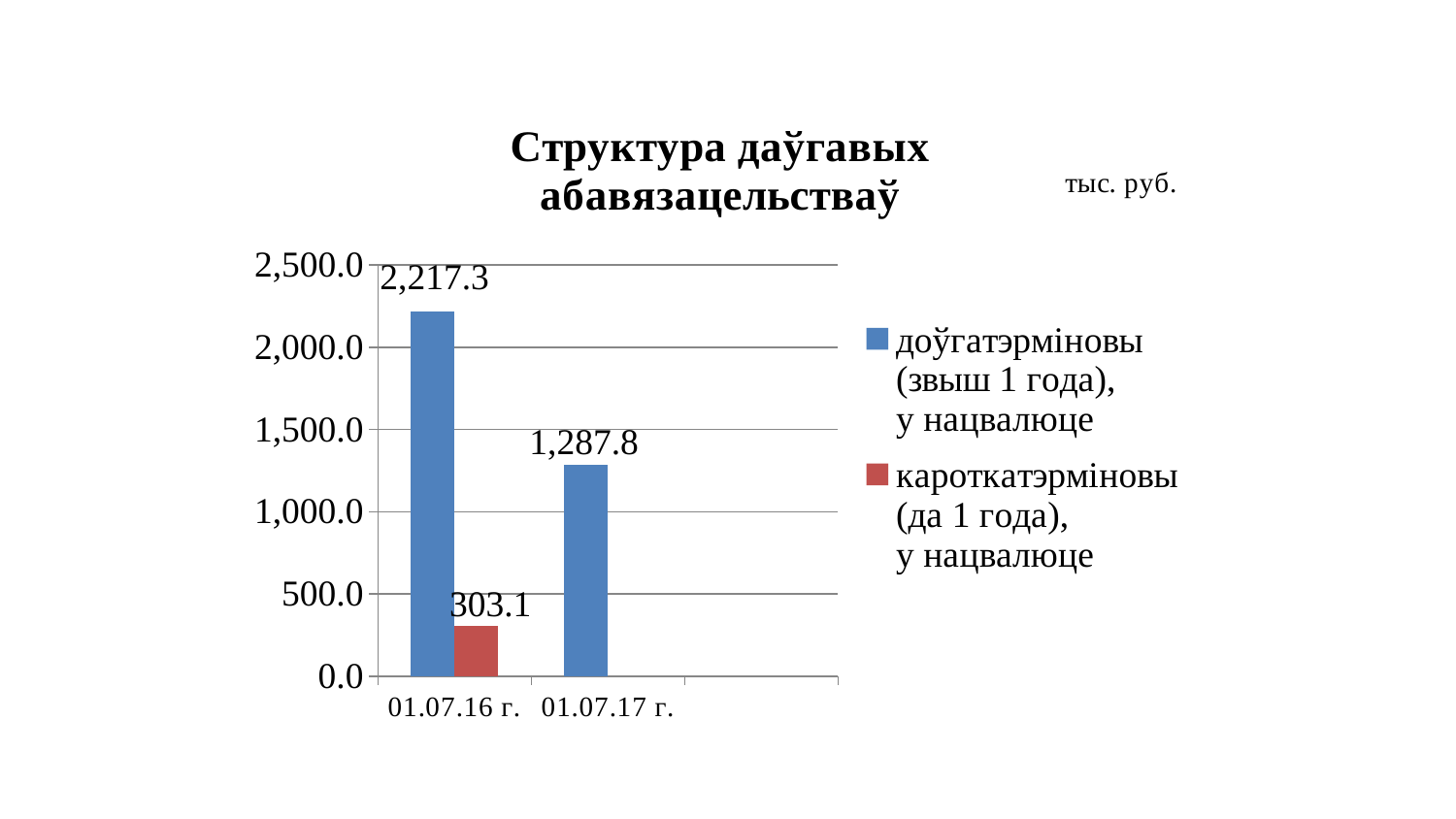
Does the long-term (доўгатэрміновы) value rise or fall from 01.07.16 г. to 01.07.17 г.? fall By how much did the long-term (доўгатэрміновы) value decrease from 01.07.16 г. to 01.07.17 г.? 929.5 What is the difference between the long-term and short-term values for 01.07.16 г.? 1,914.2 What unit of measurement is indicated next to the chart title? тыс. руб. What is the value of the long-term (доўгатэрміновы) series for 01.07.16 г.? 2,217.3 What kind of chart is shown on the slide? bar chart Which date has the higher long-term (доўгатэрміновы) value, 01.07.16 г. or 01.07.17 г.? 01.07.16 г. What is the value of the short-term (кароткатэрміновы) series for 01.07.16 г.? 303.1 How many dates (categories) are shown on the x axis? 2 What is the value of the long-term (доўгатэрміновы) series for 01.07.17 г.? 1,287.8 How many series does the legend list? 2 Is the short-term (кароткатэрміновы) value for 01.07.16 г. greater or less than 500.0? less